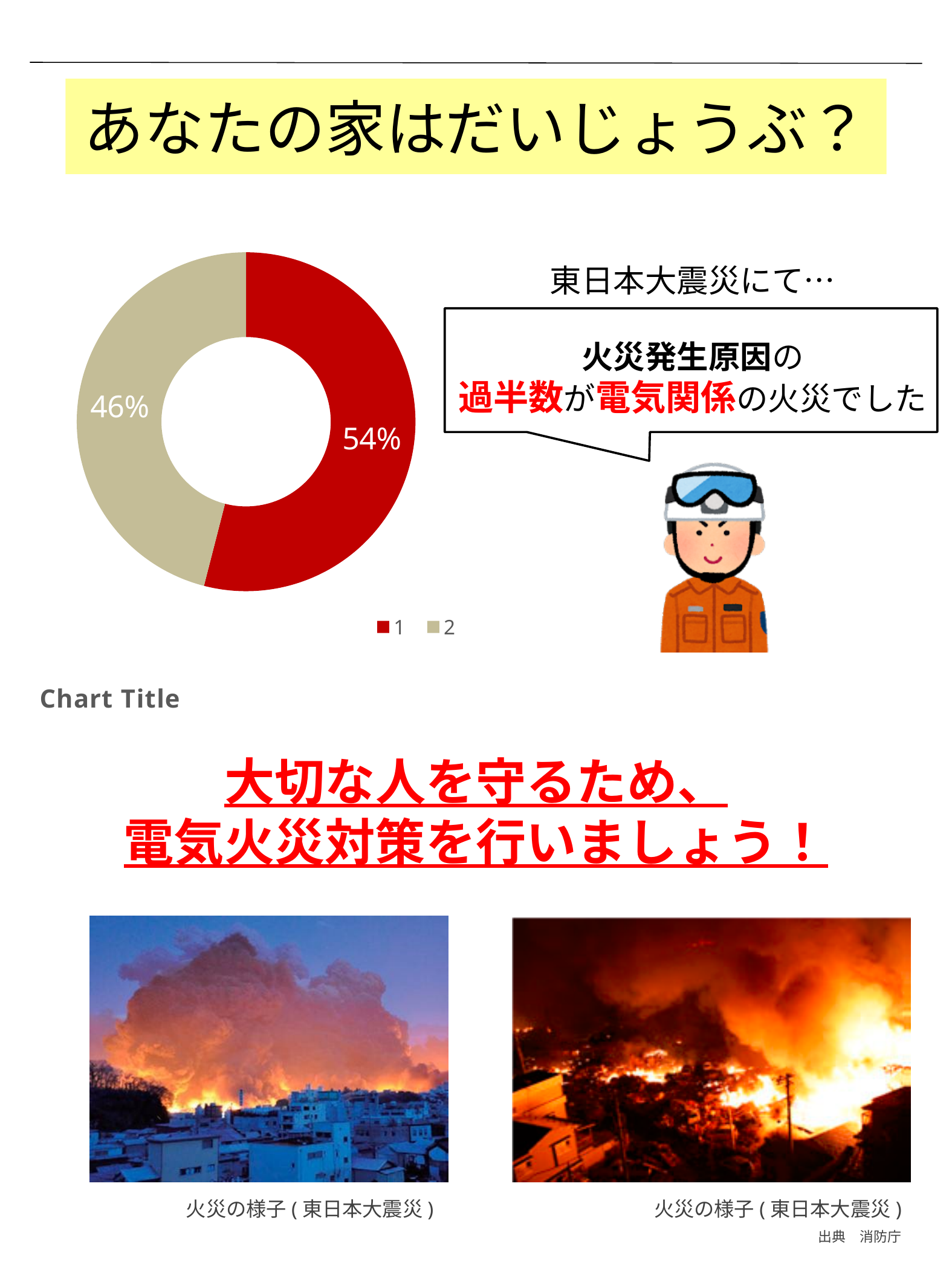
Which is larger, the share for category 1 or category 2? 1 What is the value shown for category 2 in the doughnut chart? 46% How many entries does the chart legend list? 2 What is the difference between the shares of category 1 and category 2? 8% What kind of chart is shown on the slide? Doughnut (pie) chart Which category has the largest share in the doughnut chart? 1 What title text is shown below the chart? Chart Title What is the value shown for category 1 in the doughnut chart? 54% What colour is the slice for category 1? Red How many categories does the doughnut chart show? 2 Which category has the smallest share in the doughnut chart? 2